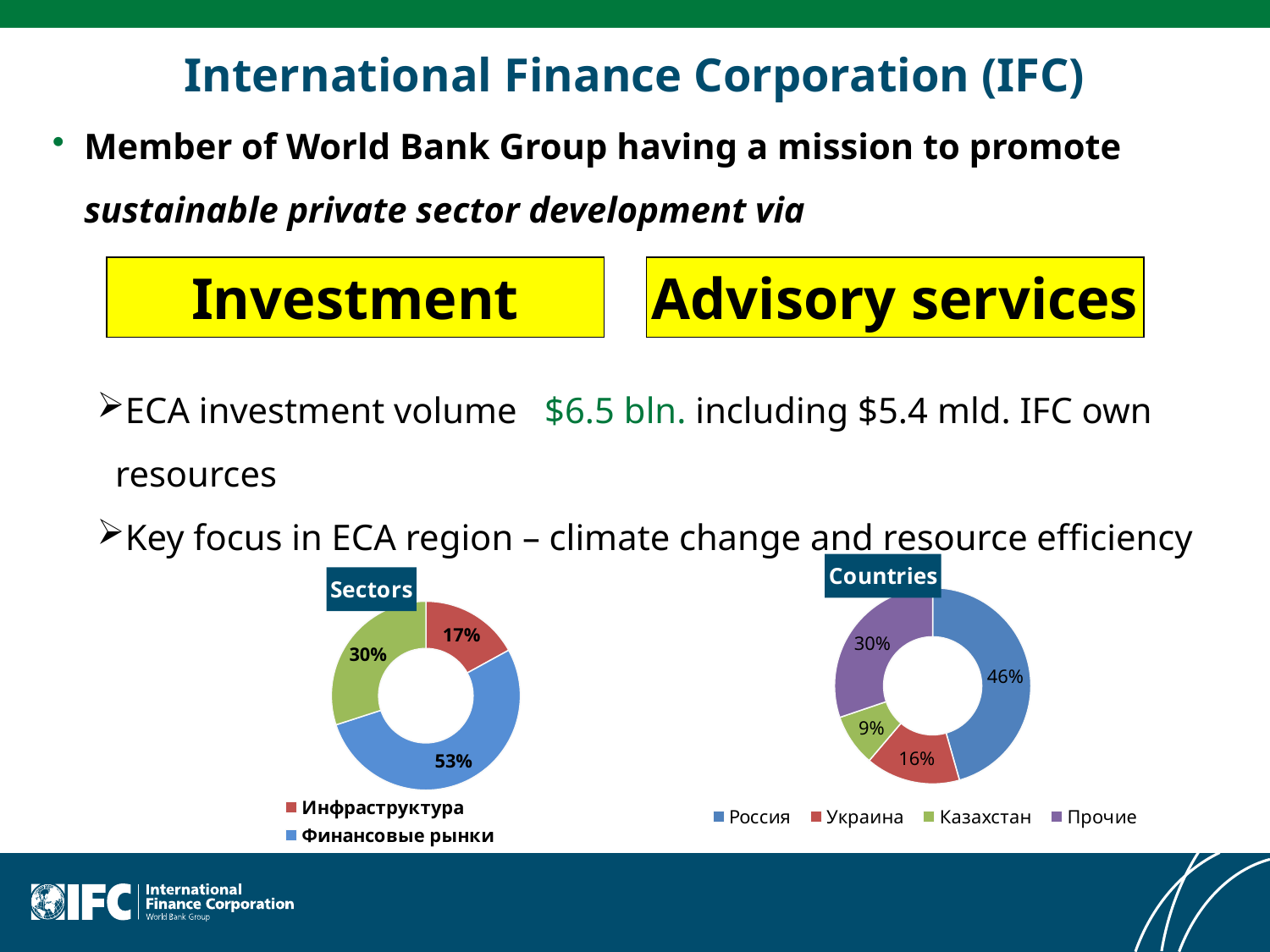
In the Sectors chart, which is larger: Финансовые рынки or Инфраструктура? Финансовые рынки In the Countries chart, which category has the smallest share? Казахстан In the Sectors chart, what share does Финансовые рынки have? 53% What type of chart is the Sectors chart? Doughnut (pie) chart In the Countries chart, what share does Казахстан have? 9% In the Countries chart, what share does Украина have? 16% In the Countries chart, which country has the largest share? Россия In the Countries chart, which is larger: the share of Прочие or the share of Украина? Прочие In the Countries chart, what is the difference between the shares of Россия and Украина? 30% In the Sectors chart, what share does Инфраструктура have? 17% In the Countries chart, what share does Россия have? 46% How many categories does the Countries chart show? 4